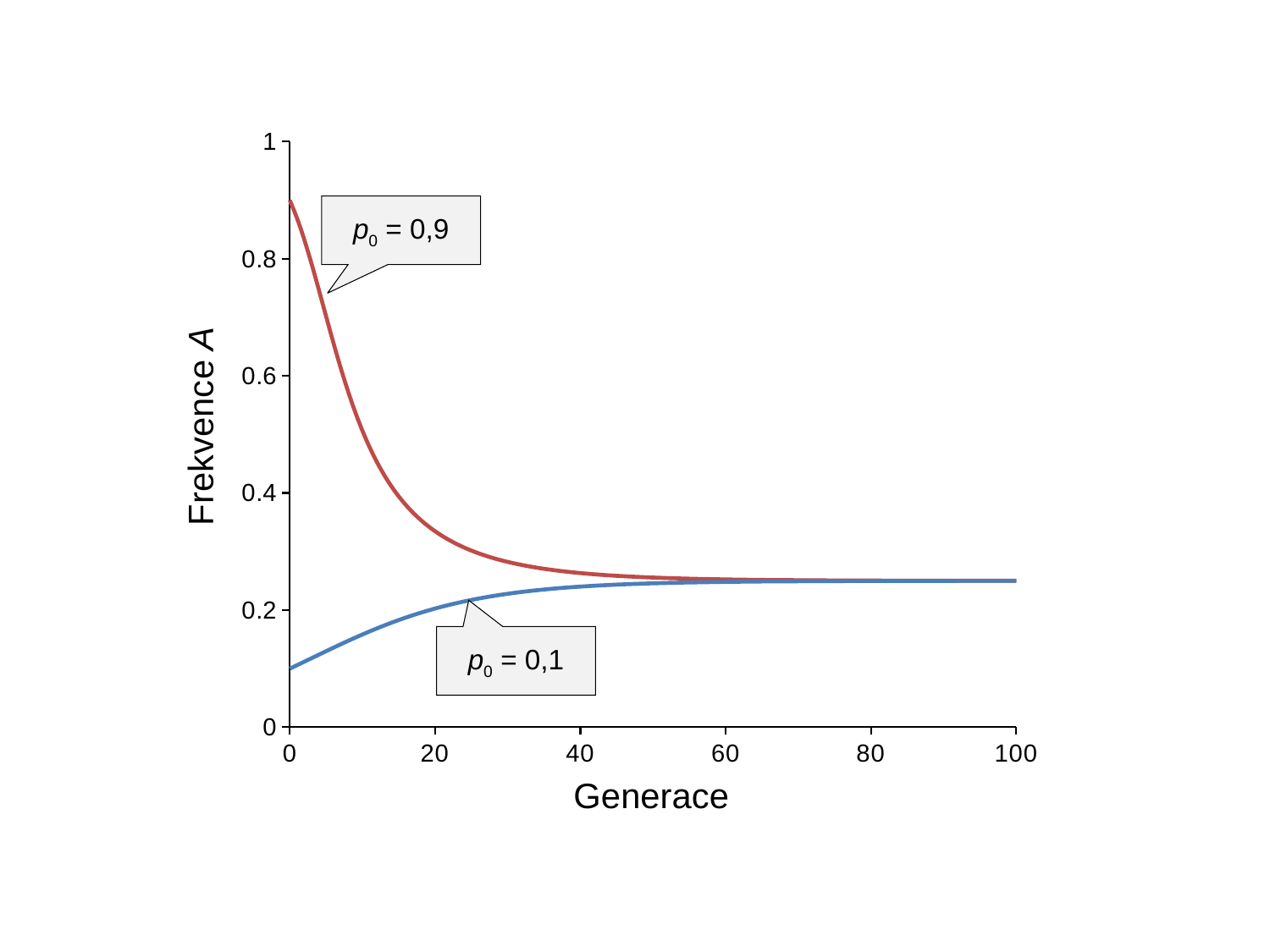
Is the value of the red line at generation 20 greater or less than 0.4? less Does the blue line (p0 = 0,1) rise or fall as the number of generations increases? rise At generation 20, which line has the higher frequency, the red line or the blue line? red line What is the starting frequency (p0) of the blue line? 0,1 Is the value of the red line at generation 10 greater or less than 0.4? greater What is the difference between the starting frequencies of the red line (p0 = 0,9) and the blue line (p0 = 0,1)? 0,8 What is the starting frequency (p0) of the red line? 0,9 How many lines (series) are plotted on the chart? 2 What is the label of the x axis? Generace What kind of chart is shown on the slide? line chart Does the red line (p0 = 0,9) rise or fall as the number of generations increases? fall Is the value of the blue line at generation 100 greater or less than 0.2? greater